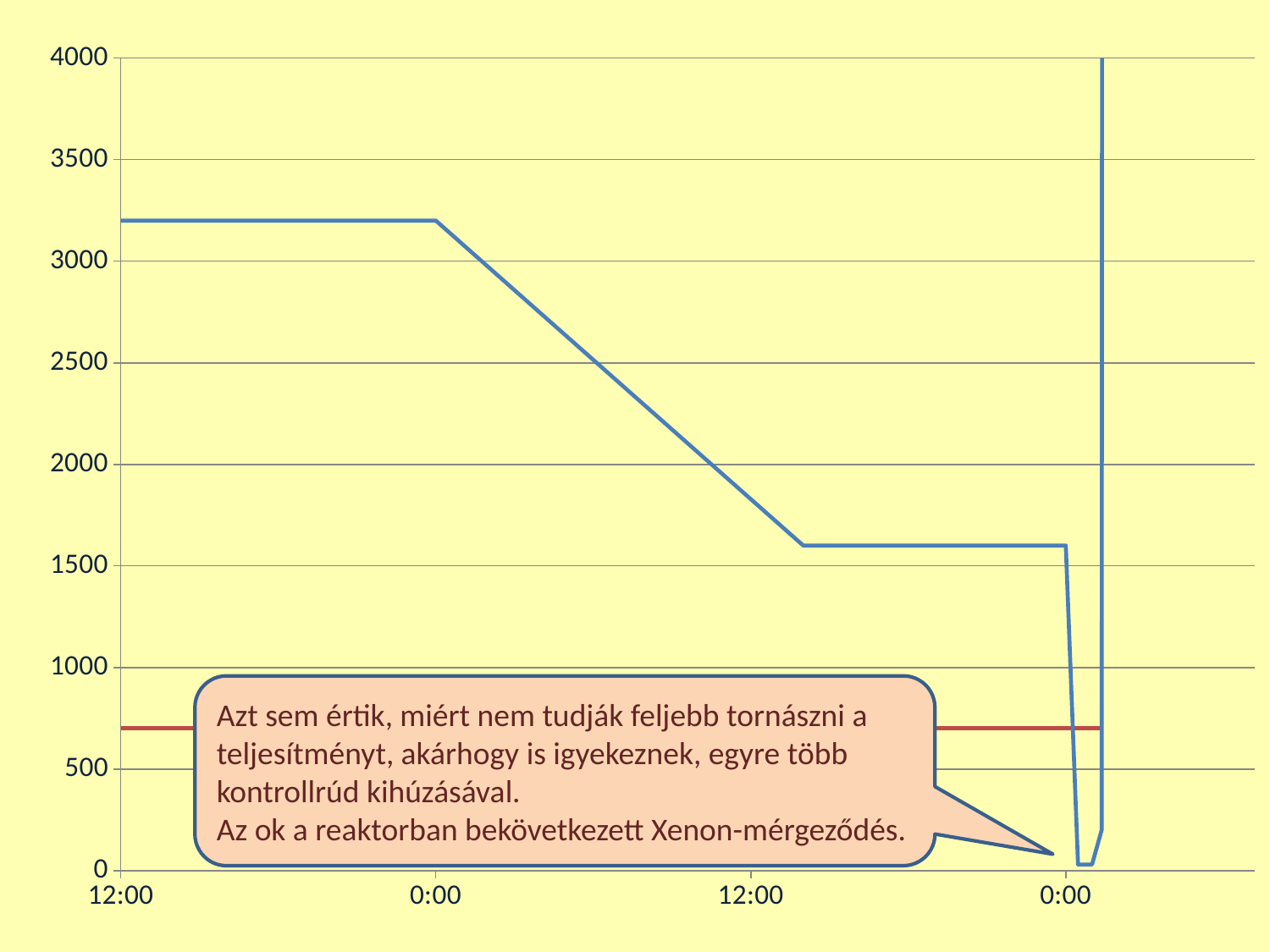
How many time labels are shown on the horizontal axis? 4 Is the value of the blue line at the second 12:00 label greater or less than 1500? greater Is the red horizontal line above or below 500 on the vertical axis? above Does the blue line rise or fall between the first 0:00 label and the second 12:00 label? fall Is the value of the blue line at the first 0:00 label greater or less than 3500? less Is the blue line higher at the first 12:00 label or at the second 12:00 label? first 12:00 What kind of chart is shown on the slide? line chart What is the highest value on the vertical axis? 4000 What colour is the horizontal line drawn across the chart near the bottom? red